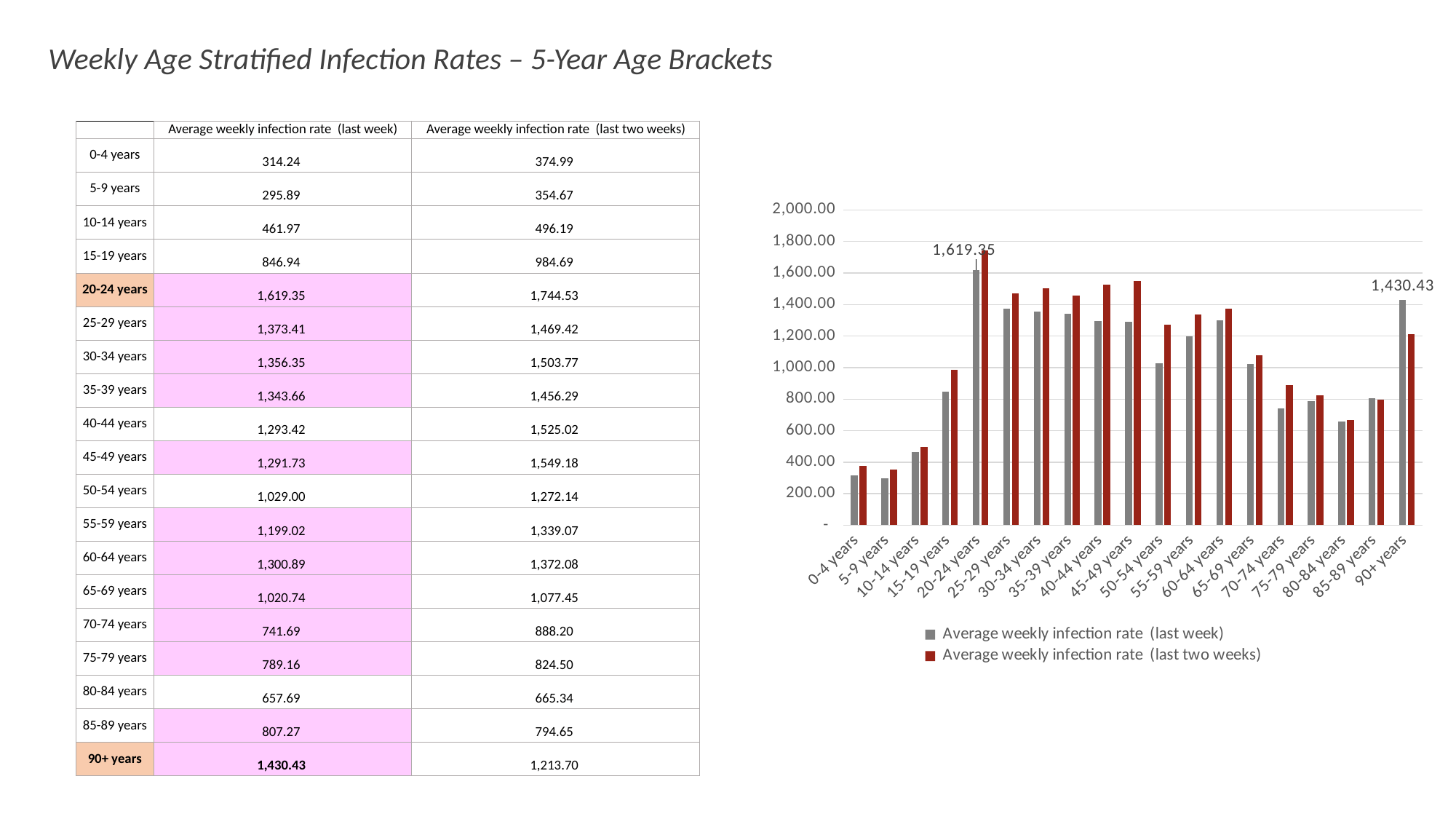
How many age brackets are plotted along the x axis of the chart? 19 How many series does the chart legend list? 2 Does the average weekly infection rate (last week) rise or fall from 0-4 years to 20-24 years? rise Which age bracket has the highest average weekly infection rate (last week)? 20-24 years Which age bracket has the lowest average weekly infection rate (last week)? 5-9 years What is the average weekly infection rate (last week) for 90+ years shown on the chart? 1,430.43 What kind of chart is shown on the slide? bar chart What is the difference between the last week rates for 20-24 years and 90+ years? 188.92 For 90+ years, which is larger: the last week rate or the last two weeks rate? last week Is the average weekly infection rate (last week) for 50-54 years greater or less than 1,200? less Which age bracket has the highest average weekly infection rate (last two weeks)? 20-24 years What is the average weekly infection rate (last week) for 20-24 years shown on the chart? 1,619.35